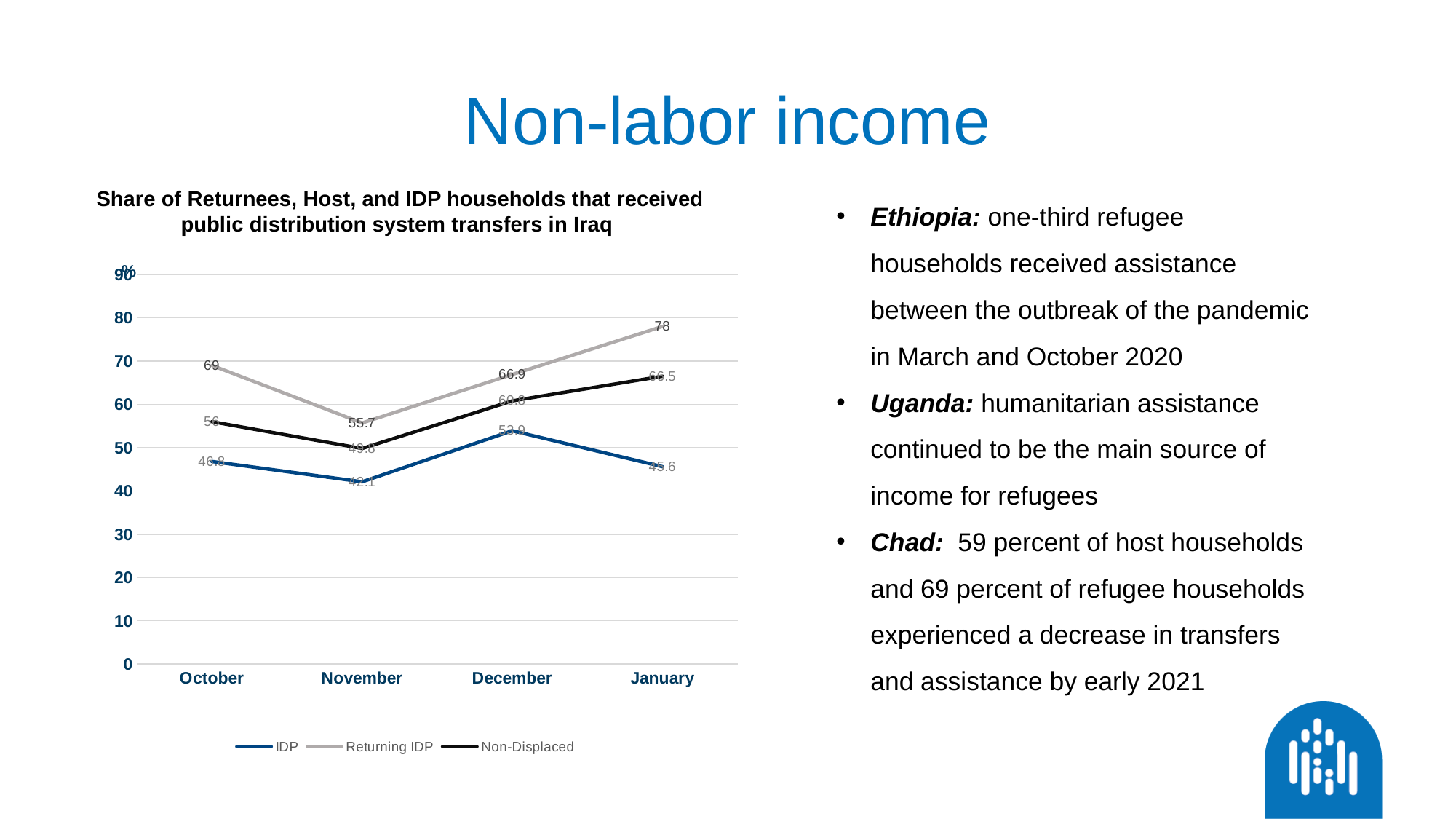
In which month is the IDP value lowest? November Is the Non-Displaced value in January greater or less than 60? greater What is the value for IDP in November? 42.1 What is the difference between the Returning IDP values in January and October? 9 What is the value for Returning IDP in January? 78 How many months are shown on the x axis? 4 What is the value for Returning IDP in November? 55.7 In October, which is larger: the Returning IDP value or the Non-Displaced value? Returning IDP What is the value for Non-Displaced in October? 56 How many series does the legend list? 3 What kind of chart is shown on the slide? Line chart In which month is the Returning IDP value highest? January